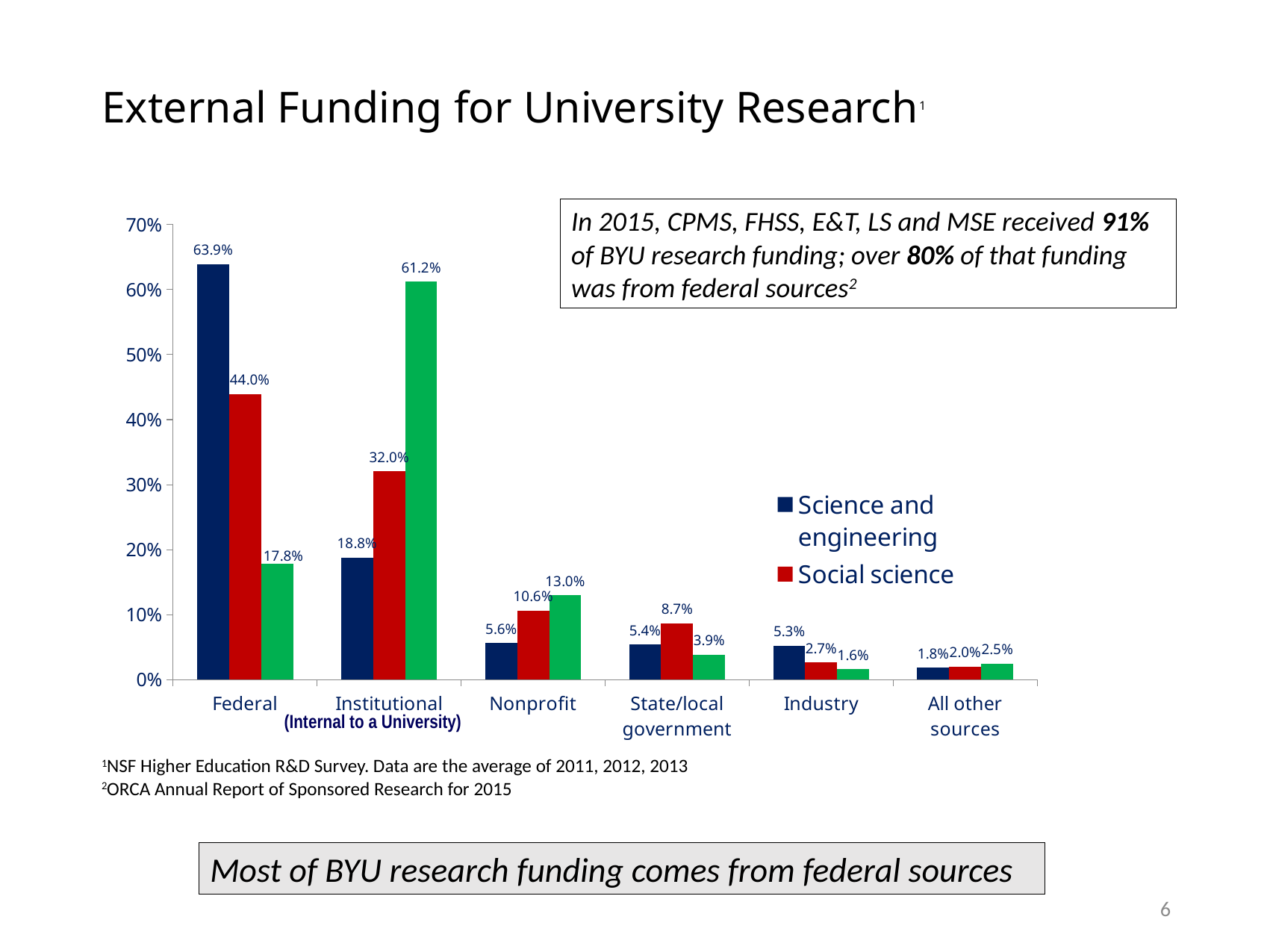
What kind of chart is shown on the slide? bar chart What is the title of the slide? External Funding for University Research What is the Social science value for Institutional? 32.0% What is the Science and engineering value for Federal? 63.9% Which category has the lowest Social science value? All other sources For Nonprofit, which is larger: the Science and engineering value or the Social science value? Social science What is the Social science value for State/local government? 8.7% What is the difference between the Science and engineering and Social science values for Federal? 19.9% Which category has the highest Science and engineering value? Federal Is the Social science value for Federal greater or less than 40%? greater How many funding source categories are shown on the x axis? 6 How many series does the legend list? 2